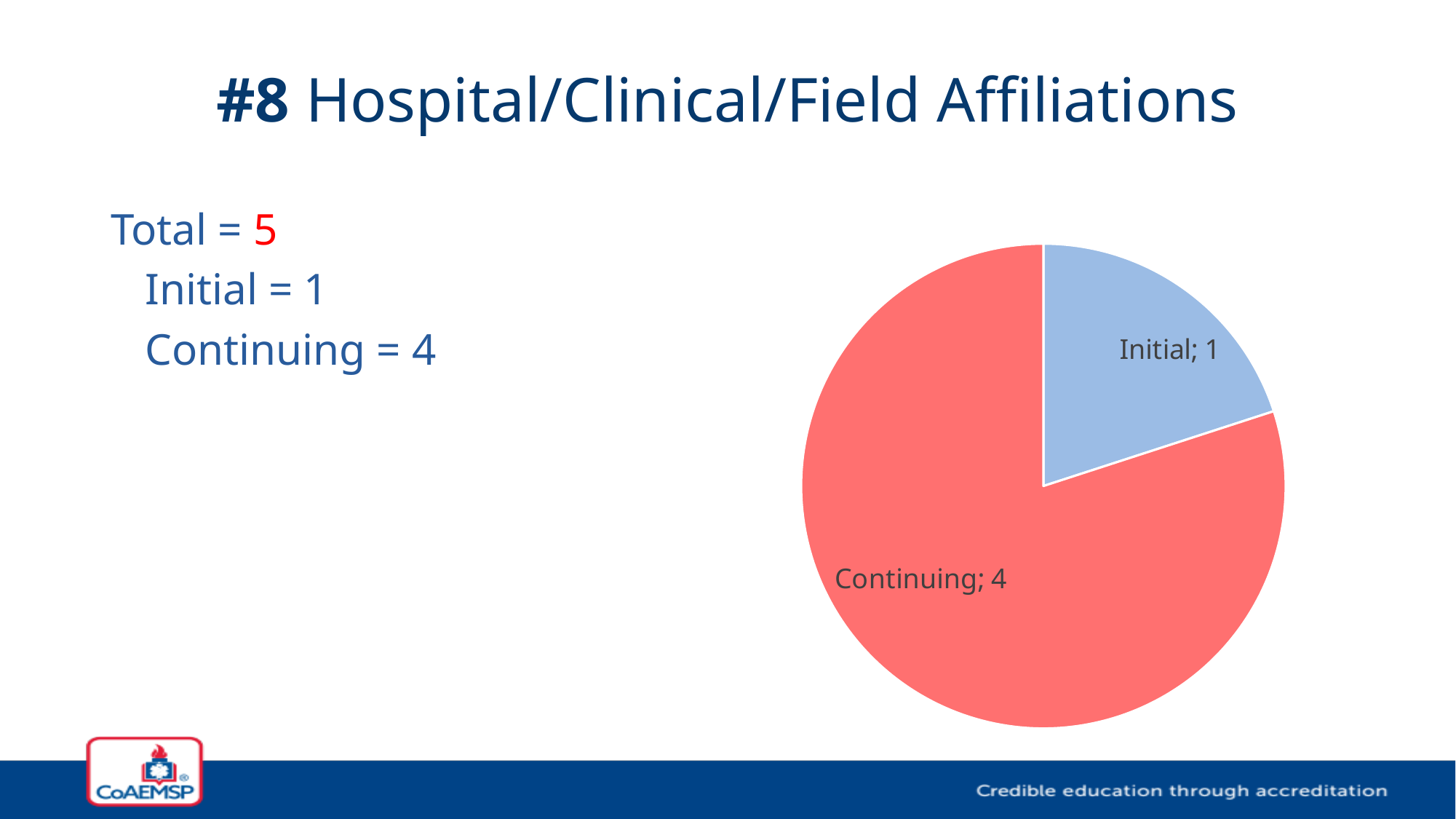
What is the value for Continuing in the pie chart? 4 Which category has the smallest slice in the pie chart? Initial What share of the pie does the Continuing slice represent? 80% What is the total of all slices in the pie chart? 5 What kind of chart is shown on the slide? pie chart What is the value for Initial in the pie chart? 1 Which category has the largest slice in the pie chart? Continuing What colour is the Continuing slice in the pie chart? red What share of the pie does the Initial slice represent? 20% Which is larger, Initial or Continuing? Continuing What is the difference between the Continuing and Initial values? 3 How many slices does the pie chart have? 2